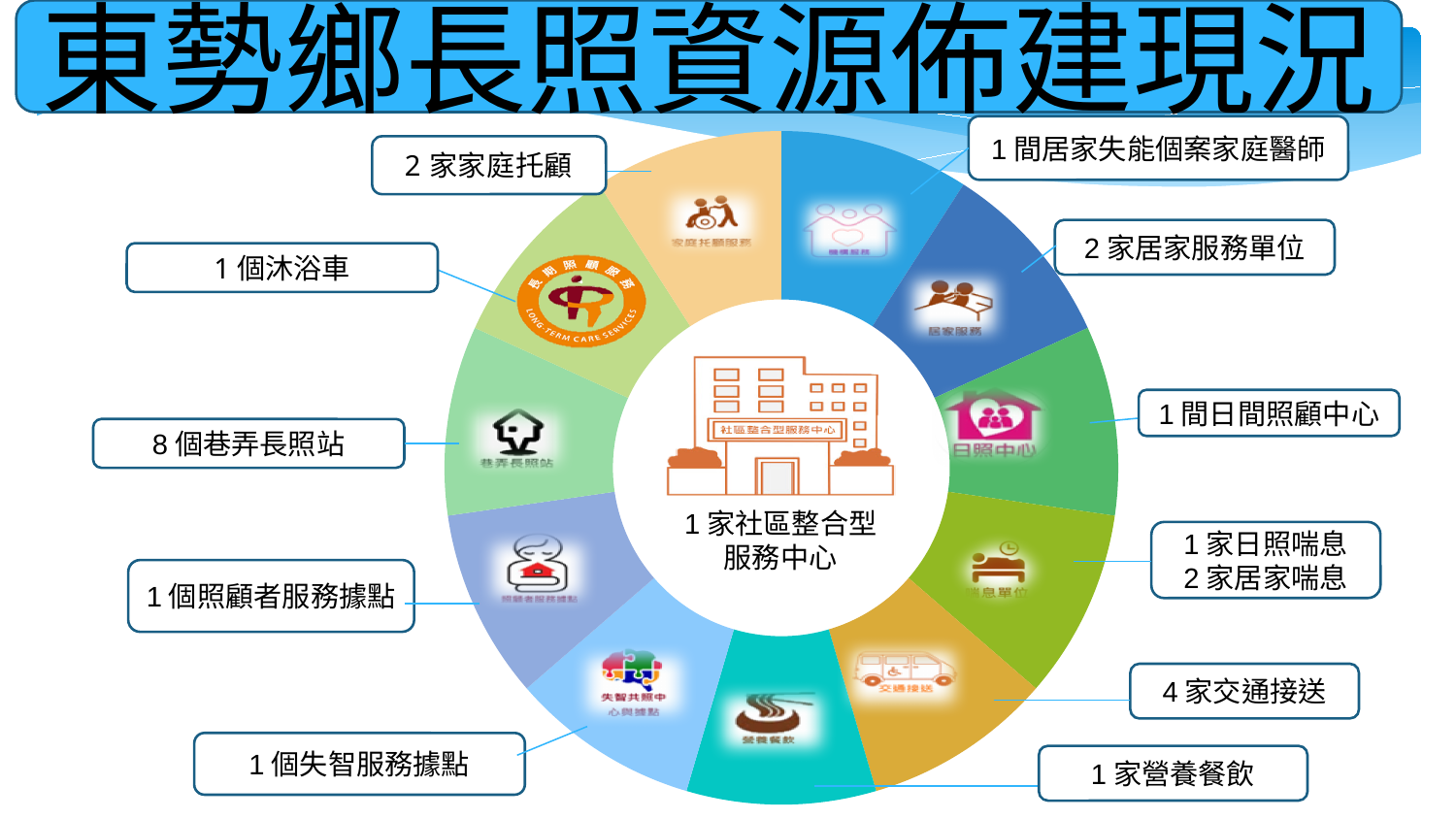
交通接送有幾家？ 4 家 巷弄長照站有幾個？ 8 個 圖表的標題是什麼？ 東勢鄉長照資源佈建現況 交通接送與家庭托顧，哪一項的數量較多？ 交通接送 在所有標示的資源中，哪一項的數量最多？ 巷弄長照站 環形圖中央標示的是什麼？ 1 家社區整合型服務中心 家庭托顧有幾家？ 2 家 日間照顧中心有幾間？ 1 間 居家喘息有幾家？ 2 家 環形圖共分成幾個區塊？ 11 這張圖是什麼類型的圖表？ 環形圖（甜甜圈圖） 居家服務單位有幾家？ 2 家